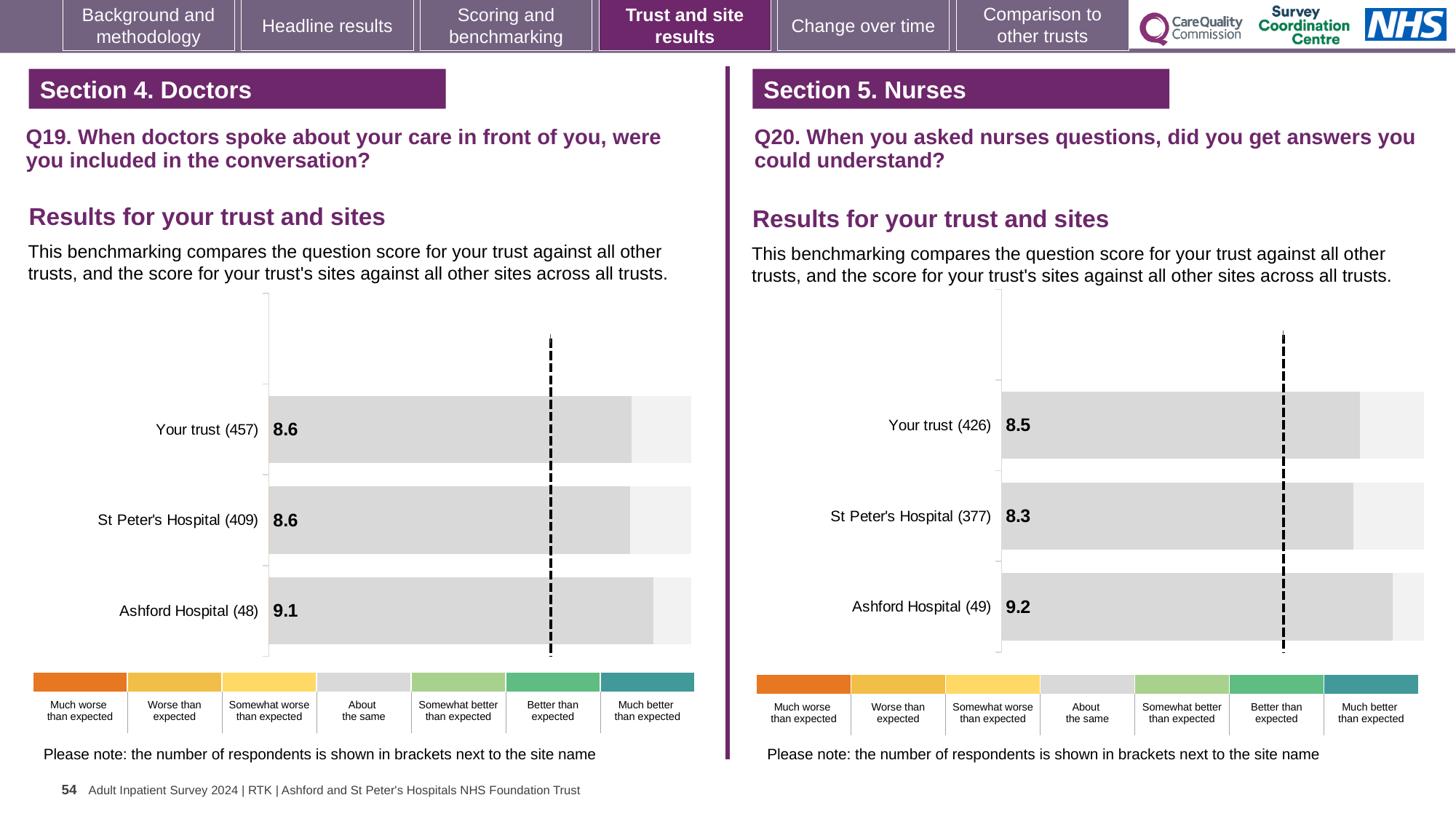
On the Q19 chart (Section 4. Doctors), what is the difference between the Ashford Hospital score and the St Peter's Hospital score? 0.5 On the Q20 chart (Section 5. Nurses), which site or trust has the lowest score? St Peter's Hospital What kind of chart is used on the Q19 chart (Section 4. Doctors)? Bar chart On the Q20 chart (Section 5. Nurses), what is the score for Your trust? 8.5 On the Q20 chart (Section 5. Nurses), how many respondents are shown in brackets for Ashford Hospital? 49 On the Q20 chart (Section 5. Nurses), which is larger, the score for Ashford Hospital or the score for Your trust? Ashford Hospital On the Q19 chart (Section 4. Doctors), which site or trust has the highest score? Ashford Hospital On the Q20 chart (Section 5. Nurses), what is the score for St Peter's Hospital? 8.3 On the Q19 chart (Section 4. Doctors), what is the score for Your trust? 8.6 On the Q20 chart (Section 5. Nurses), what is the difference between the Ashford Hospital score and the Your trust score? 0.7 On the Q19 chart (Section 4. Doctors), how many bars are plotted? 3 On the Q19 chart (Section 4. Doctors), what is the score for Ashford Hospital? 9.1